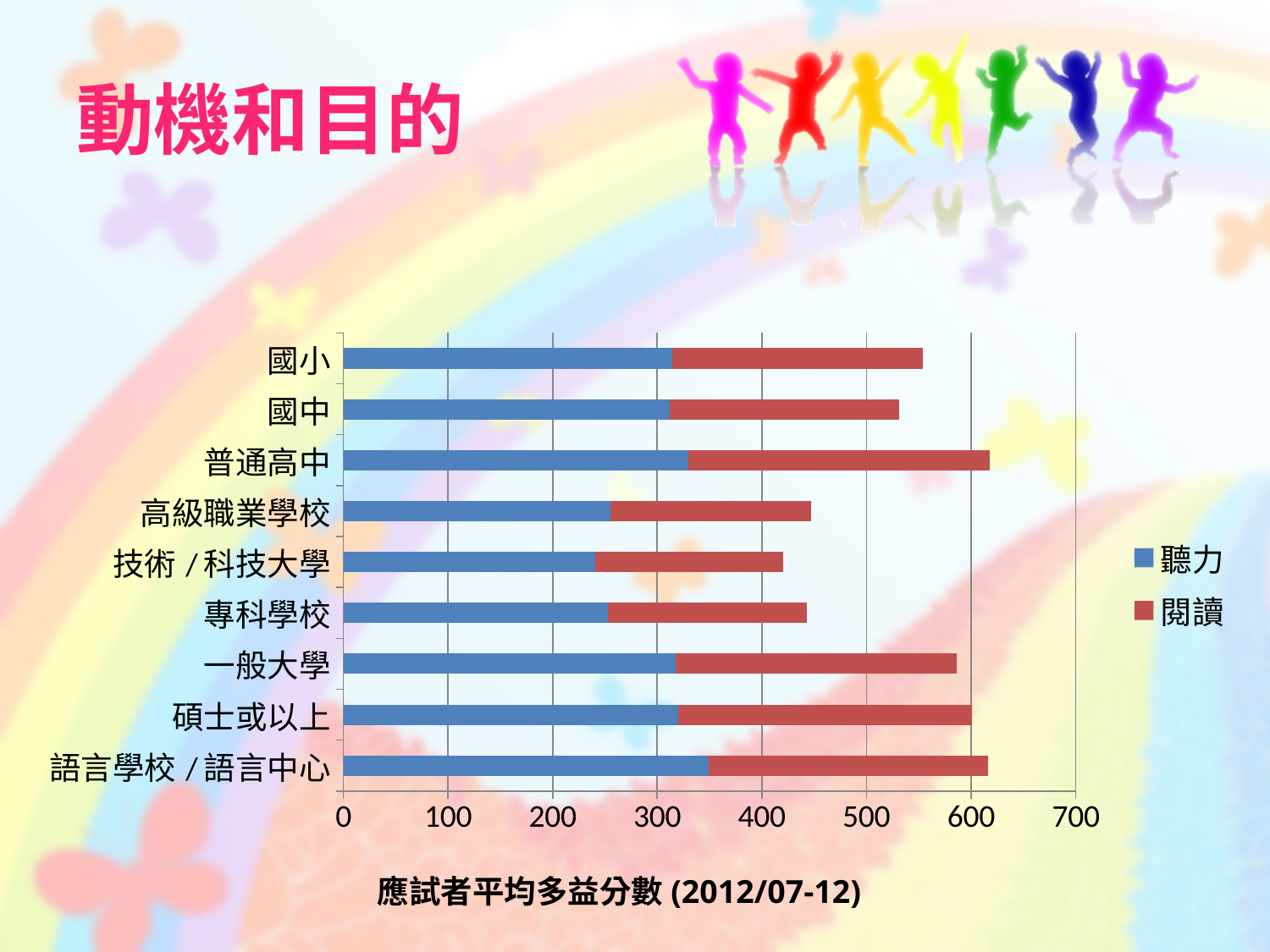
How many series does the legend list? 2 Is the 聽力 value for 高級職業學校 greater or less than 300? less Is the total value for 國小 greater or less than 500? greater Is the total value for 技術／科技大學 greater or less than 500? less What is the title of the chart? 應試者平均多益分數 (2012/07-12) What kind of chart is shown on the slide? bar chart How many categories are plotted on the chart? 9 Which series is shown in blue? 聽力 Which has the larger total value, 碩士或以上 or 專科學校? 碩士或以上 Which has the larger total value, 國小 or 高級職業學校? 國小